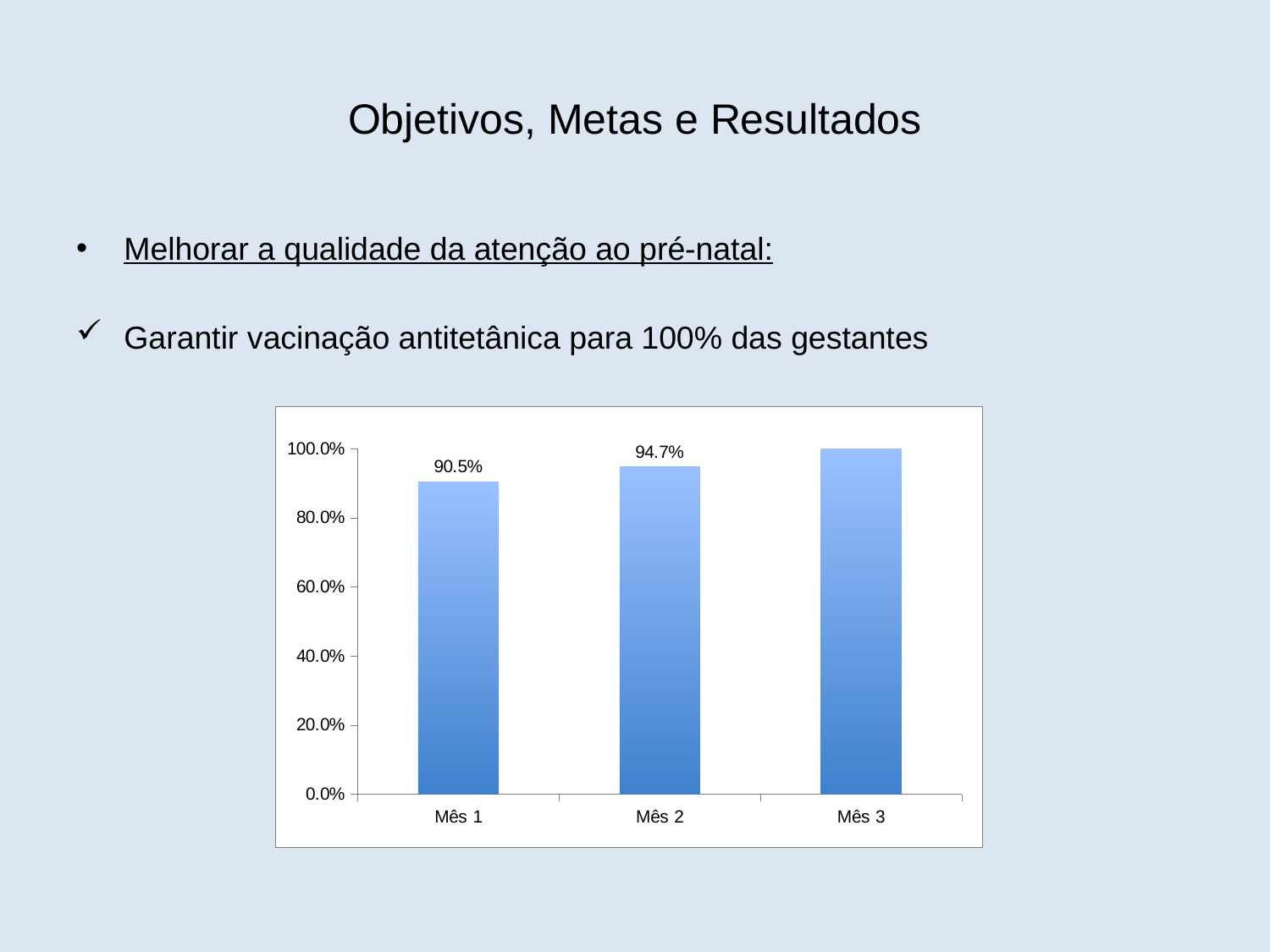
What is the difference between the values for Mês 2 and Mês 1? 4.2% What is the highest value shown on the y axis? 100.0% Do the values rise or fall from Mês 1 to Mês 3? rise Which month has the highest value? Mês 3 What is the value for Mês 3? 100.0% Is the value for Mês 1 greater or less than 80.0%? greater What is the value for Mês 1? 90.5% What is the value for Mês 2? 94.7% Which month has the lowest value? Mês 1 How many months are shown on the x axis? 3 Which is larger, the value for Mês 1 or the value for Mês 2? Mês 2 What kind of chart is shown on the slide? bar chart